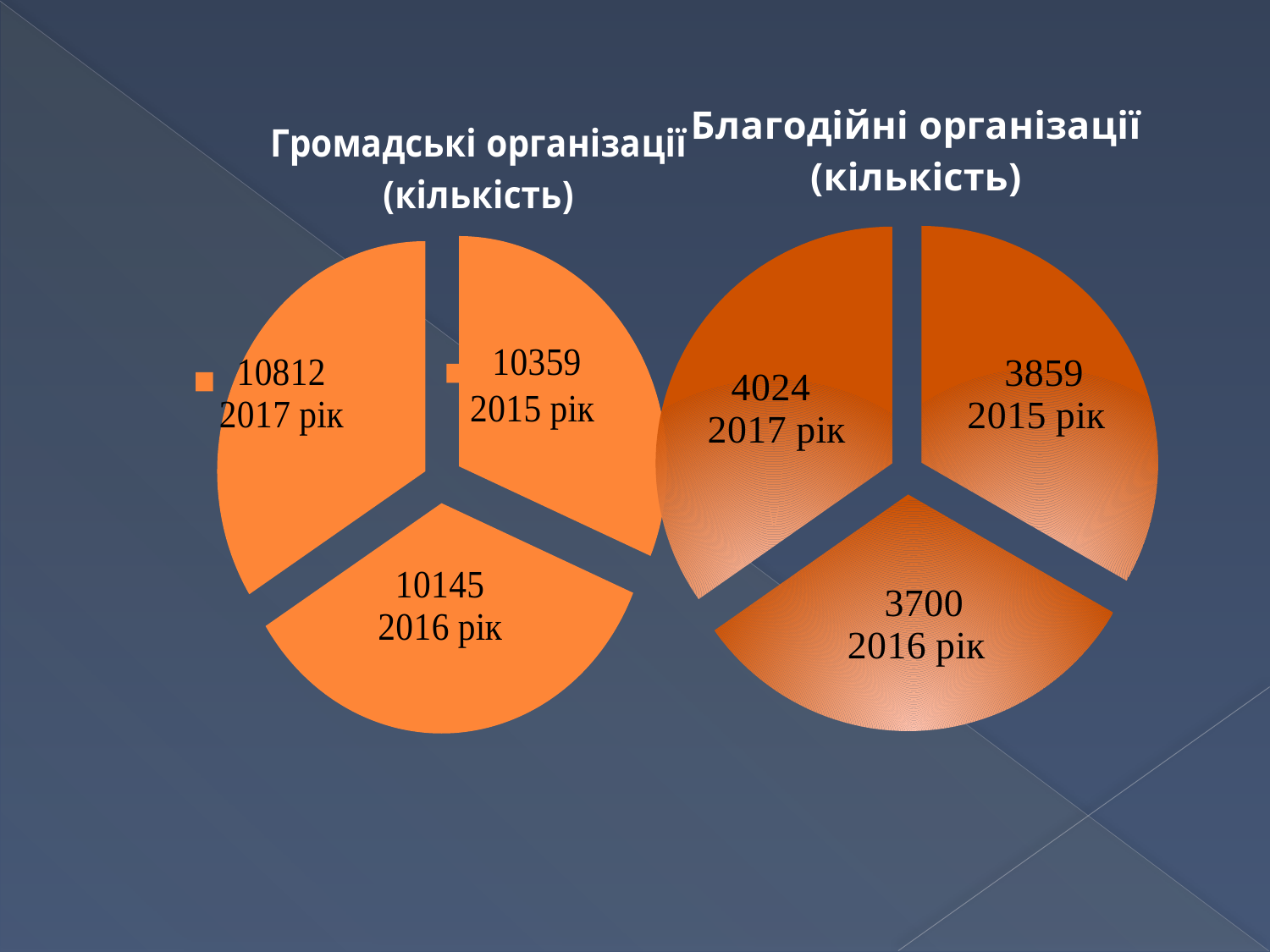
What is the total of all slices in the chart titled "Благодійні організації (кількість)"? 11583 In the chart titled "Громадські організації (кількість)", which year has the highest value? 2017 рік How many slices does the chart titled "Громадські організації (кількість)" have? 3 In the chart titled "Громадські організації (кількість)", what is the difference between the values for 2017 рік and 2016 рік? 667 In the chart titled "Громадські організації (кількість)", what is the value for 2017 рік? 10812 In the chart titled "Благодійні організації (кількість)", which is larger, the value for 2015 рік or the value for 2016 рік? 2015 рік In the chart titled "Благодійні організації (кількість)", what is the difference between the values for 2017 рік and 2015 рік? 165 What kind of chart is the chart titled "Благодійні організації (кількість)"? Pie chart In the chart titled "Благодійні організації (кількість)", what is the value for 2017 рік? 4024 In the chart titled "Благодійні організації (кількість)", which year has the lowest value? 2016 рік In the chart titled "Благодійні організації (кількість)", what is the value for 2016 рік? 3700 In the chart titled "Громадські організації (кількість)", what is the value for 2015 рік? 10359